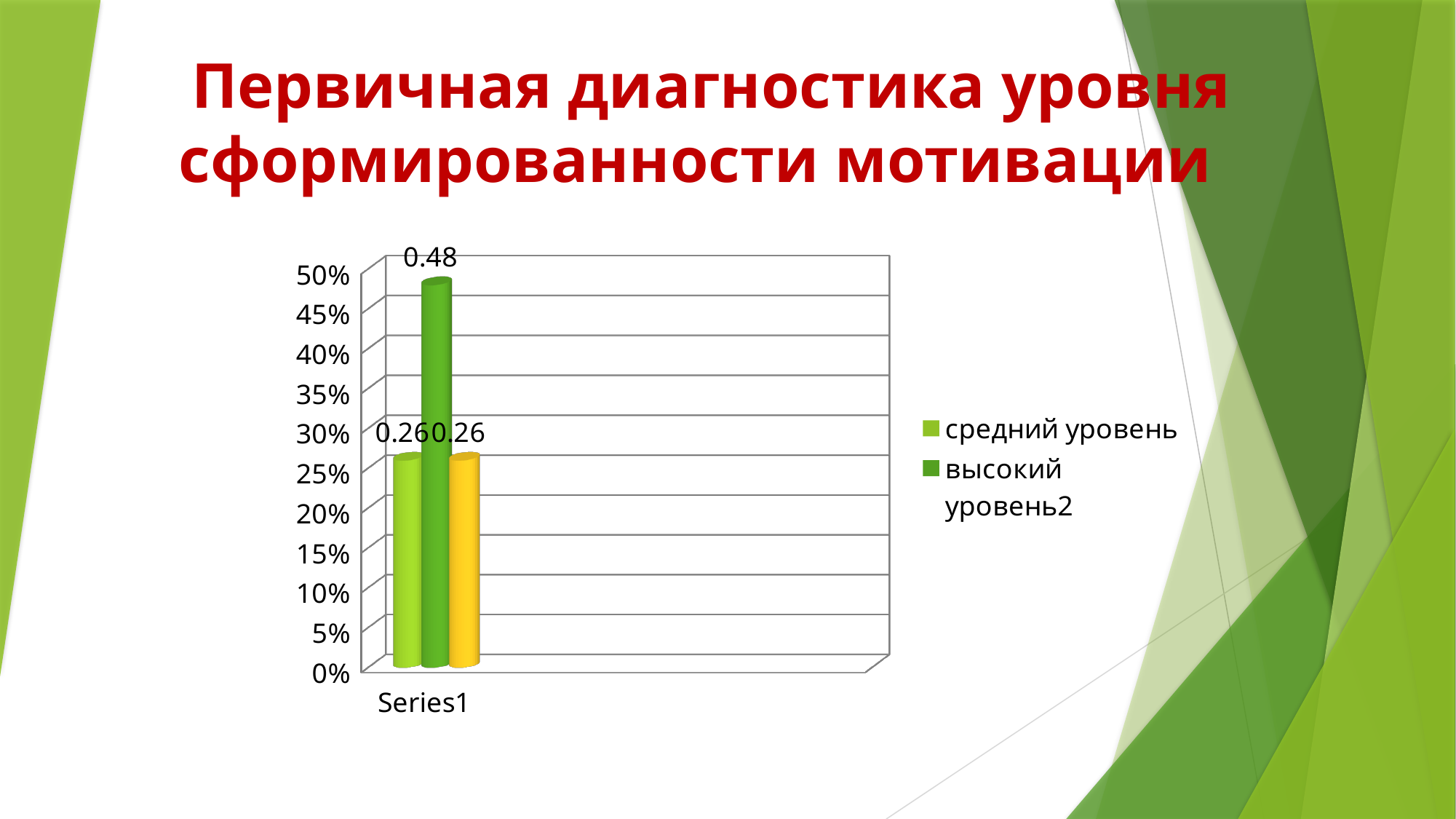
How many bars are plotted on the chart? 3 What kind of chart is shown on the slide? bar chart What value is labelled on the yellow bar? 0.26 What label appears on the horizontal axis of the chart? Series1 What is the value of the bar for высокий уровень2? 0.48 Is the bar for средний уровень greater or less than 30%? less Which is larger, the value for средний уровень or the value for высокий уровень2? высокий уровень2 How many series does the legend list? 2 Which legend series has the highest bar? высокий уровень2 What is the value of the bar for средний уровень? 0.26 What is the difference between the values for высокий уровень2 and средний уровень? 0.22 Is the bar for высокий уровень2 greater or less than 40%? greater